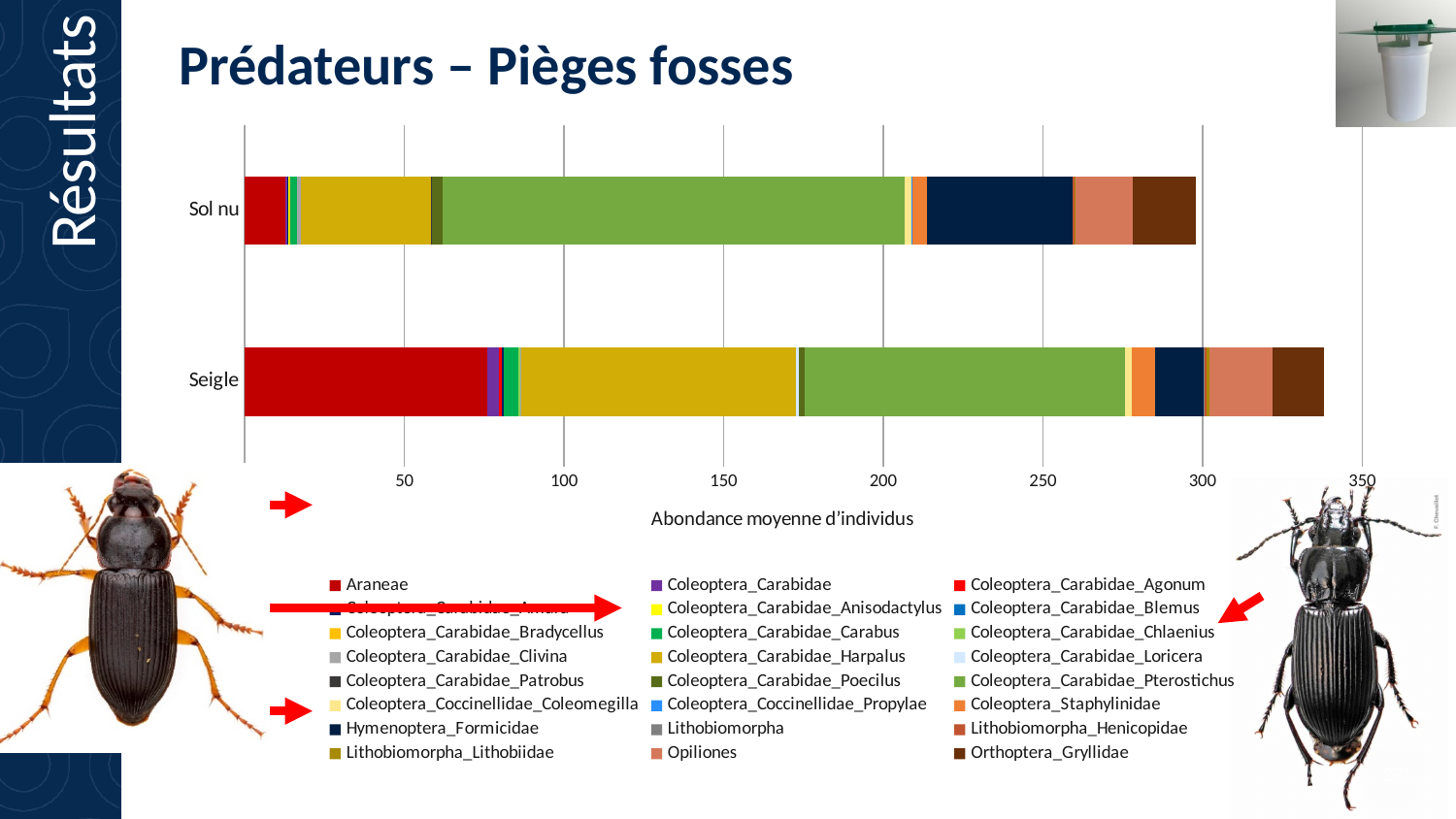
What is the title of the horizontal axis of the chart? Abondance moyenne d'individus Which category has the longer total stacked bar, Sol nu or Seigle? Seigle What are the two categories shown on the vertical axis of the chart? Sol nu and Seigle How many series does the chart legend list? 24 Which category has the lowest total abundance? Sol nu Is the leftmost (first) segment of the Seigle bar greater or less than 50? greater Is the total value of the Seigle bar greater or less than 300? greater Is the total value of the Seigle bar greater or less than 350? less How many categories (bars) are plotted on the chart? 2 What kind of chart is shown on the slide? Stacked bar chart Which category has the highest total abundance? Seigle